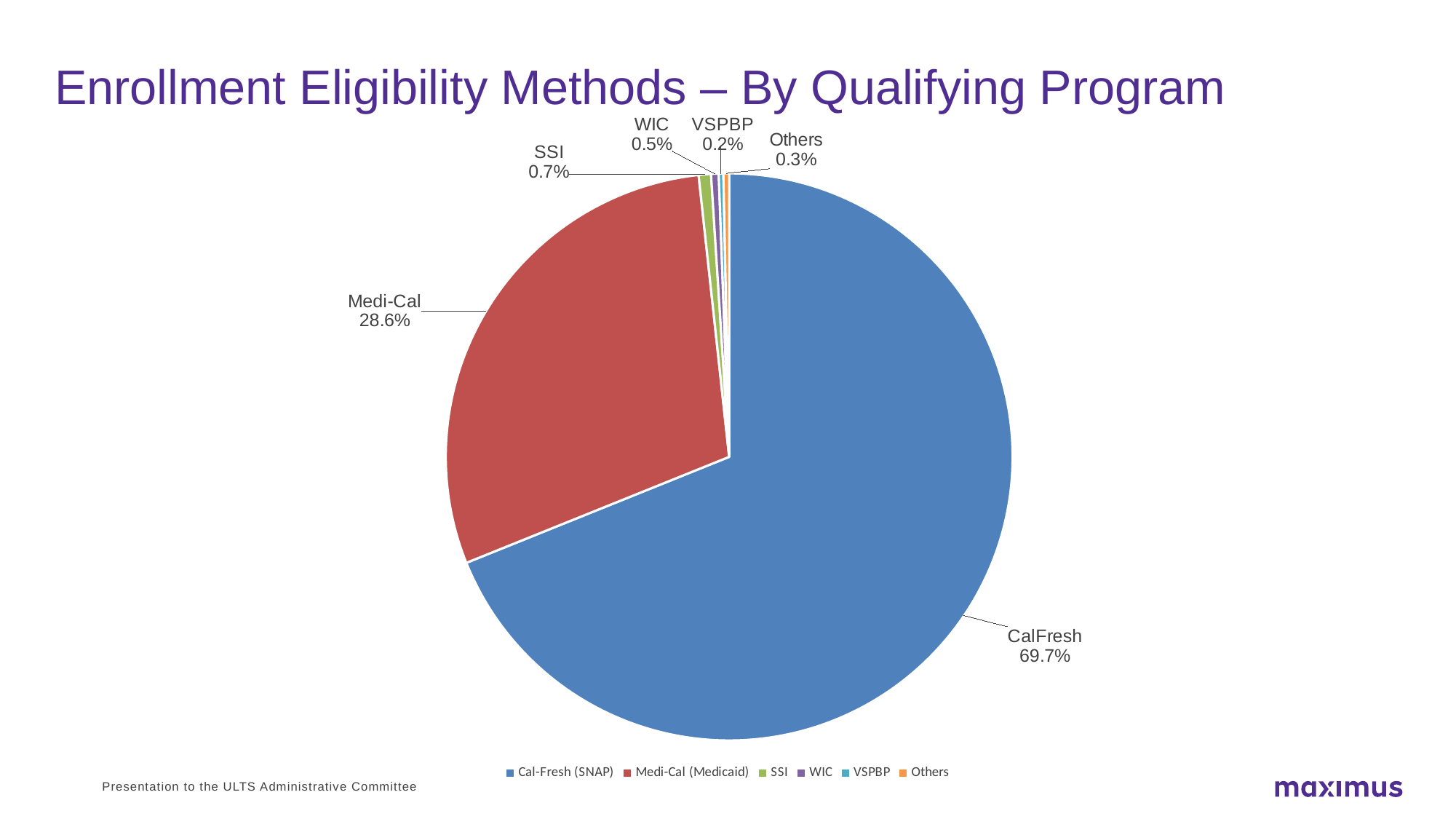
Which qualifying program has the largest slice of the pie? CalFresh What is the title of the slide? Enrollment Eligibility Methods – By Qualifying Program What is the value shown for SSI? 0.7% Which qualifying program has the smallest slice of the pie? VSPBP How many slices does the pie chart have? 6 What is the value shown for WIC? 0.5% What is the difference in percentage points between CalFresh and Medi-Cal? 41.1 What share of the pie does Medi-Cal account for? 28.6% What share of the pie does CalFresh account for? 69.7% Which is larger, the share for SSI or the share for Others? SSI What kind of chart is shown on the slide? Pie chart What is the value shown for VSPBP? 0.2%